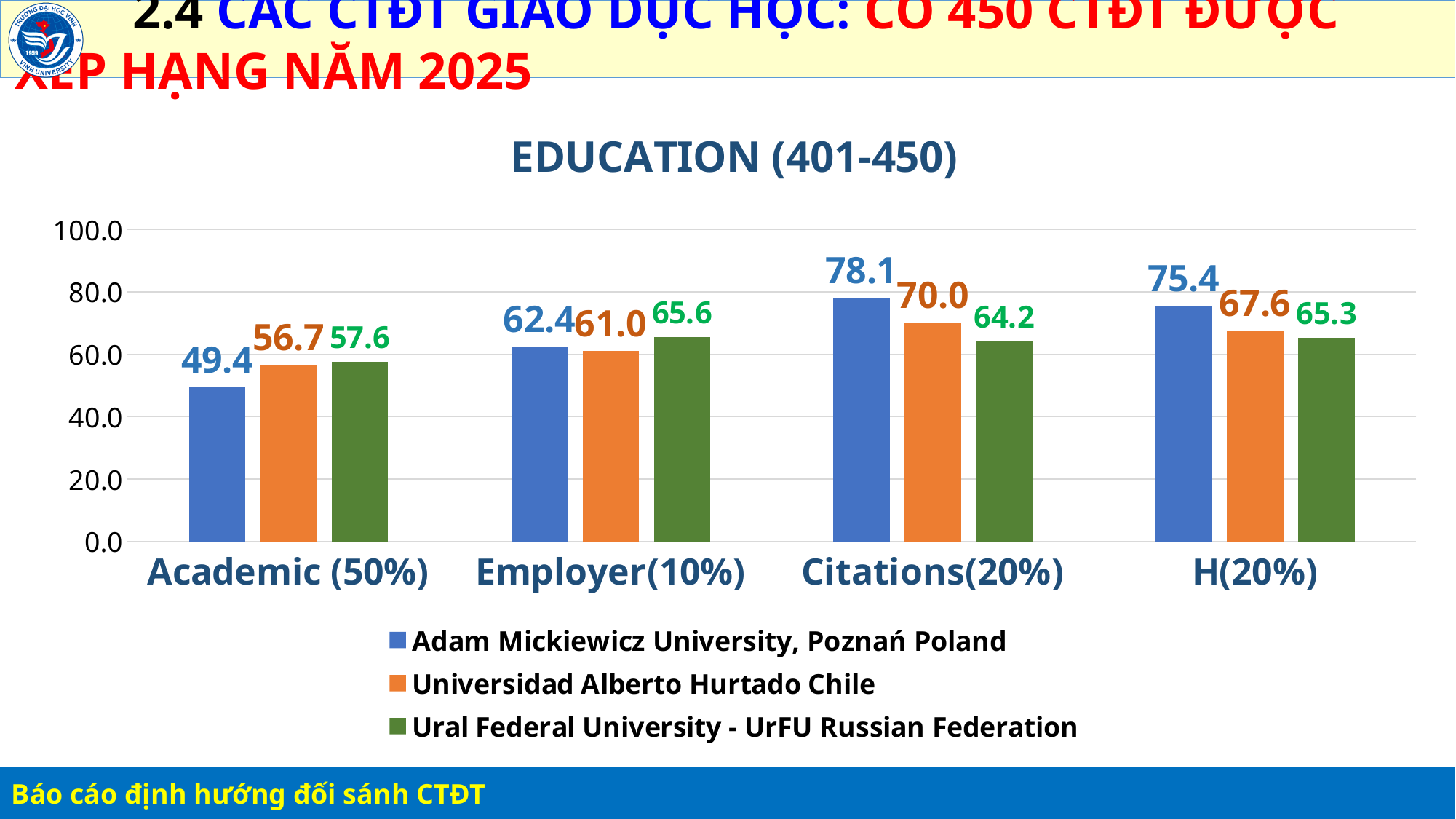
How many series does the legend list? 3 How many categories are shown on the x axis? 4 What is the value for Adam Mickiewicz University, Poznań Poland in the Academic (50%) category? 49.4 What is the difference between the Citations(20%) values of Adam Mickiewicz University, Poznań Poland and Ural Federal University - UrFU Russian Federation? 13.9 What is the value for Universidad Alberto Hurtado Chile in the H(20%) category? 67.6 What is the title of the chart? EDUCATION (401-450) In which category does Universidad Alberto Hurtado Chile have its lowest value? Academic (50%) What is the value for Universidad Alberto Hurtado Chile in the Citations(20%) category? 70.0 In which category does Adam Mickiewicz University, Poznań Poland have its highest value? Citations(20%) What is the value for Ural Federal University - UrFU Russian Federation in the Employer(10%) category? 65.6 What kind of chart is shown on the slide? Bar chart Which university has the larger value in the Academic (50%) category: Adam Mickiewicz University, Poznań Poland or Ural Federal University - UrFU Russian Federation? Ural Federal University - UrFU Russian Federation